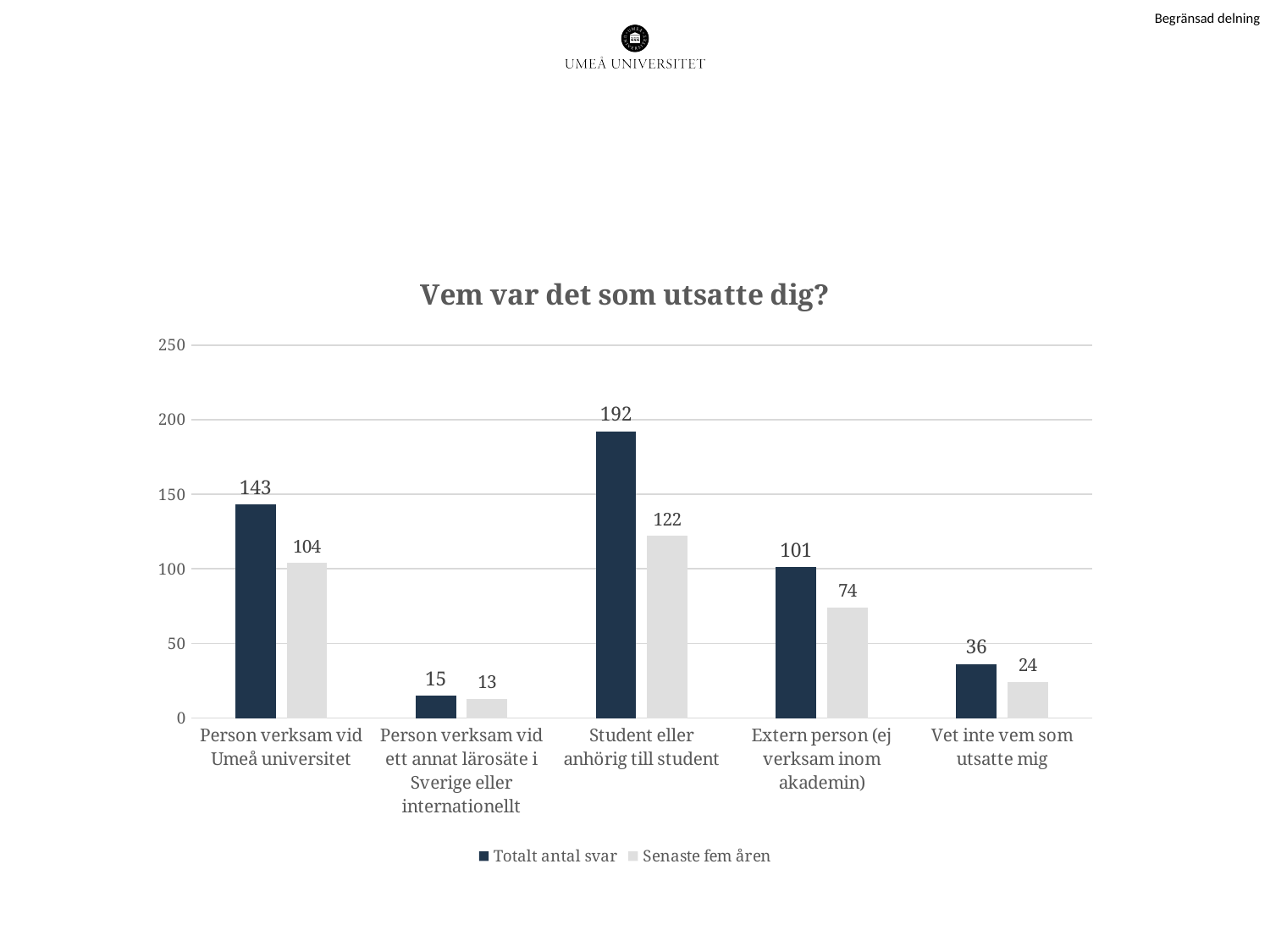
What is the value of "Senaste fem åren" for "Person verksam vid Umeå universitet"? 104 How many categories are shown on the x axis? 5 Which category has the lowest value for "Senaste fem åren"? Person verksam vid ett annat lärosäte i Sverige eller internationellt What is the value of "Senaste fem åren" for "Extern person (ej verksam inom akademin)"? 74 What is the difference between the "Totalt antal svar" values for "Student eller anhörig till student" and "Extern person (ej verksam inom akademin)"? 91 What kind of chart is shown on the slide? Bar chart What is the difference between "Totalt antal svar" and "Senaste fem åren" for "Person verksam vid Umeå universitet"? 39 How many series does the legend list? 2 What is the value of "Totalt antal svar" for "Student eller anhörig till student"? 192 Which is larger: "Totalt antal svar" for "Vet inte vem som utsatte mig" or "Senaste fem åren" for "Extern person (ej verksam inom akademin)"? Senaste fem åren for Extern person (ej verksam inom akademin) Which category has the highest value for "Totalt antal svar"? Student eller anhörig till student What is the title of the chart? Vem var det som utsatte dig?